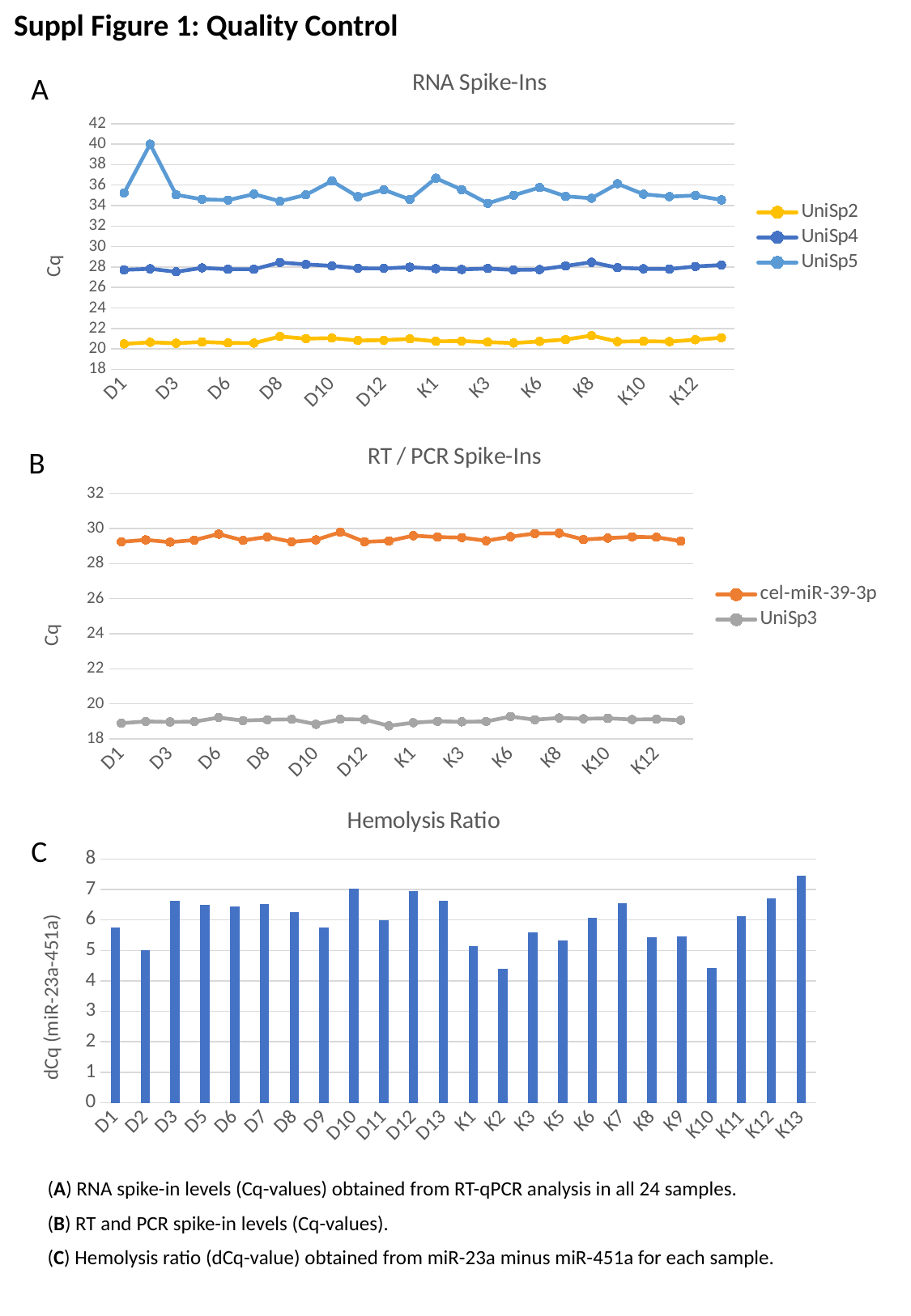
In the Hemolysis Ratio chart, which sample has the highest dCq value? K13 How many bars are shown in the Hemolysis Ratio chart? 24 What kind of chart is the Hemolysis Ratio chart? bar chart In the Hemolysis Ratio chart, is the value for D10 greater or less than 6? greater How many series does the legend of the RT / PCR Spike-Ins chart list? 2 What kind of chart is the RNA Spike-Ins chart? line chart In the Hemolysis Ratio chart, which is larger, the value for D3 or the value for D2? D3 In the RNA Spike-Ins chart, at which sample does UniSp5 reach its highest Cq value? D2 In the RT / PCR Spike-Ins chart, which series has the higher Cq values, cel-miR-39-3p or UniSp3? cel-miR-39-3p In the RNA Spike-Ins chart, is the UniSp5 value at D3 greater or less than 38? less How many series does the legend of the RNA Spike-Ins chart list? 3 In the Hemolysis Ratio chart, is the value for K2 greater or less than 5? less